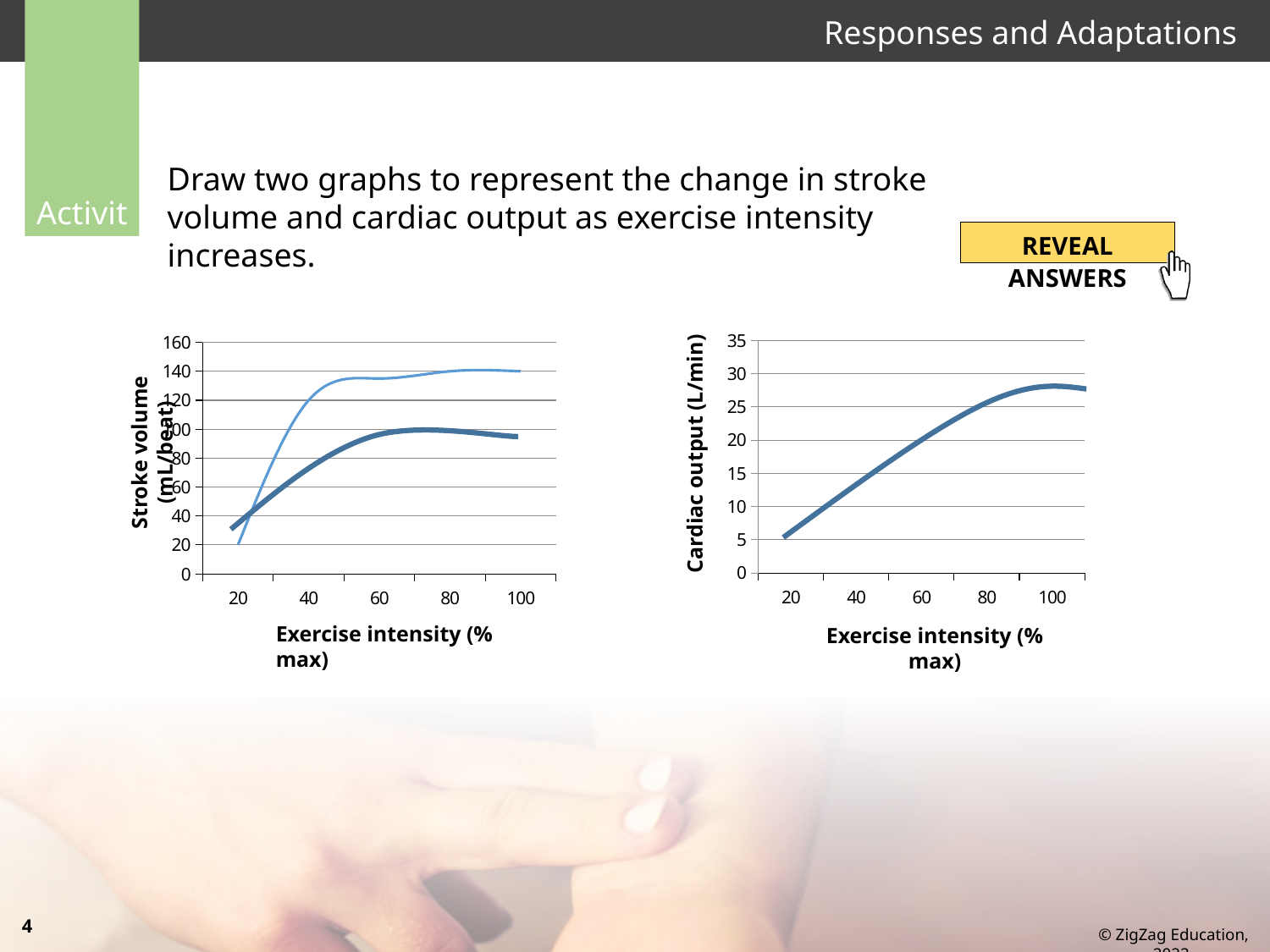
On the right chart (Cardiac output), how many lines are plotted? 1 On the left chart, does the thick dark line rise or fall as exercise intensity increases from 20 to 60? rise What is the y-axis title of the right chart? Cardiac output (L/min) On the right chart, is the cardiac output at 100% exercise intensity greater or less than 25? greater On the right chart, does cardiac output rise or fall as exercise intensity increases from 20 to 80? rise What is the highest value shown on the y-axis of the left chart? 160 On the left chart, is the value of the thin light-blue line at 100% exercise intensity greater or less than 120? greater What kind of chart is the right chart (Cardiac output)? line chart On the right chart, is the cardiac output at 20% exercise intensity greater or less than 10? less On the left chart (Stroke volume), how many lines are plotted? 2 What kind of chart is the left chart (Stroke volume)? line chart